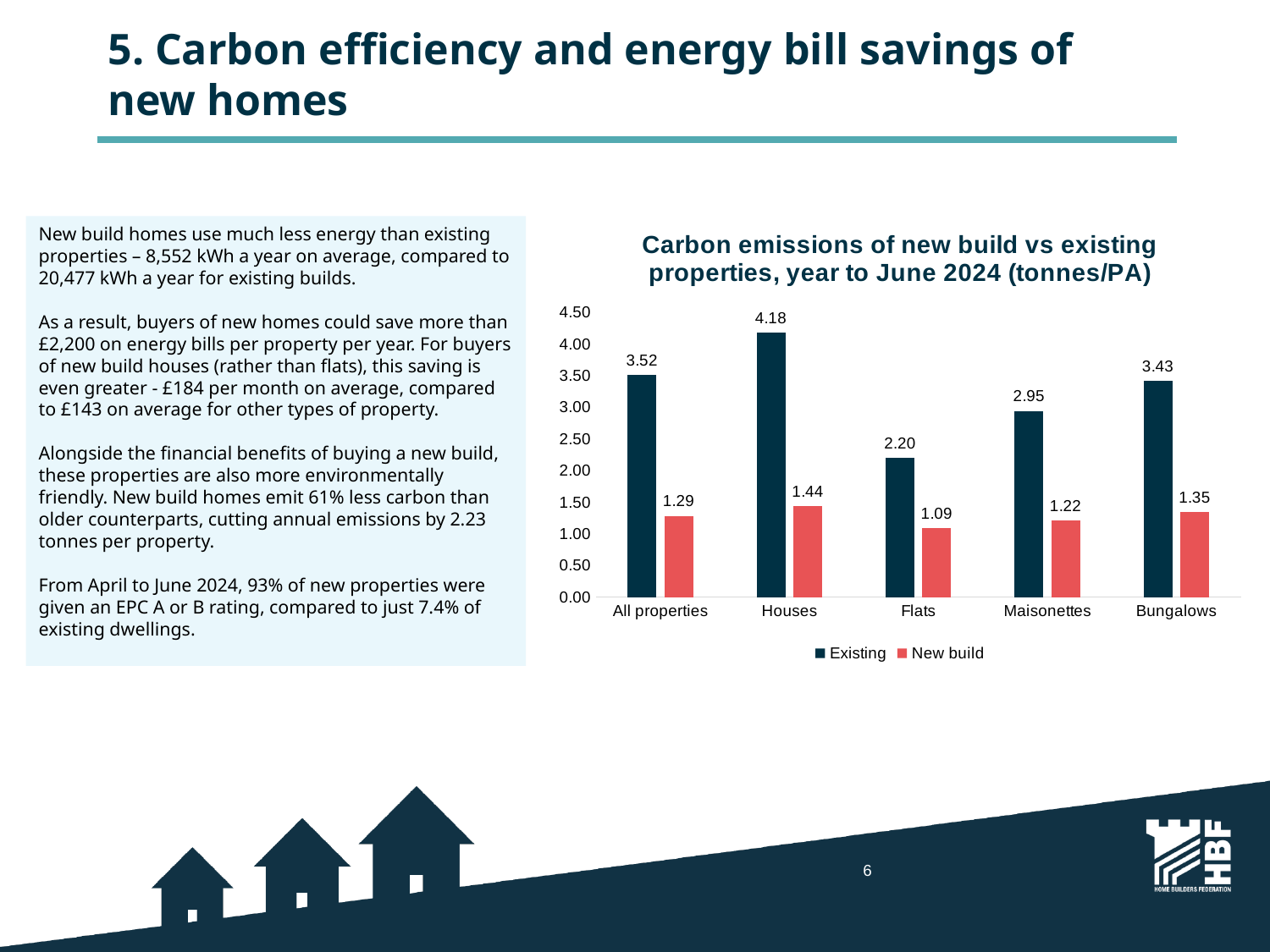
Is the Existing value for Flats greater or less than 2.00? greater How many series does the legend list? 2 How many property categories are shown on the x axis? 5 What kind of chart is shown on the slide? Bar chart Which is larger, the Existing value for Maisonettes or the Existing value for Bungalows? Bungalows Which category has the lowest New build value? Flats What is the value for New build in the All properties category? 1.29 What is the title of the chart? Carbon emissions of new build vs existing properties, year to June 2024 (tonnes/PA) Which category has the highest Existing value? Houses What is the carbon emissions value for Existing Houses? 4.18 What is the difference between the Existing and New build values for Bungalows? 2.08 What is the carbon emissions value for New build Flats? 1.09